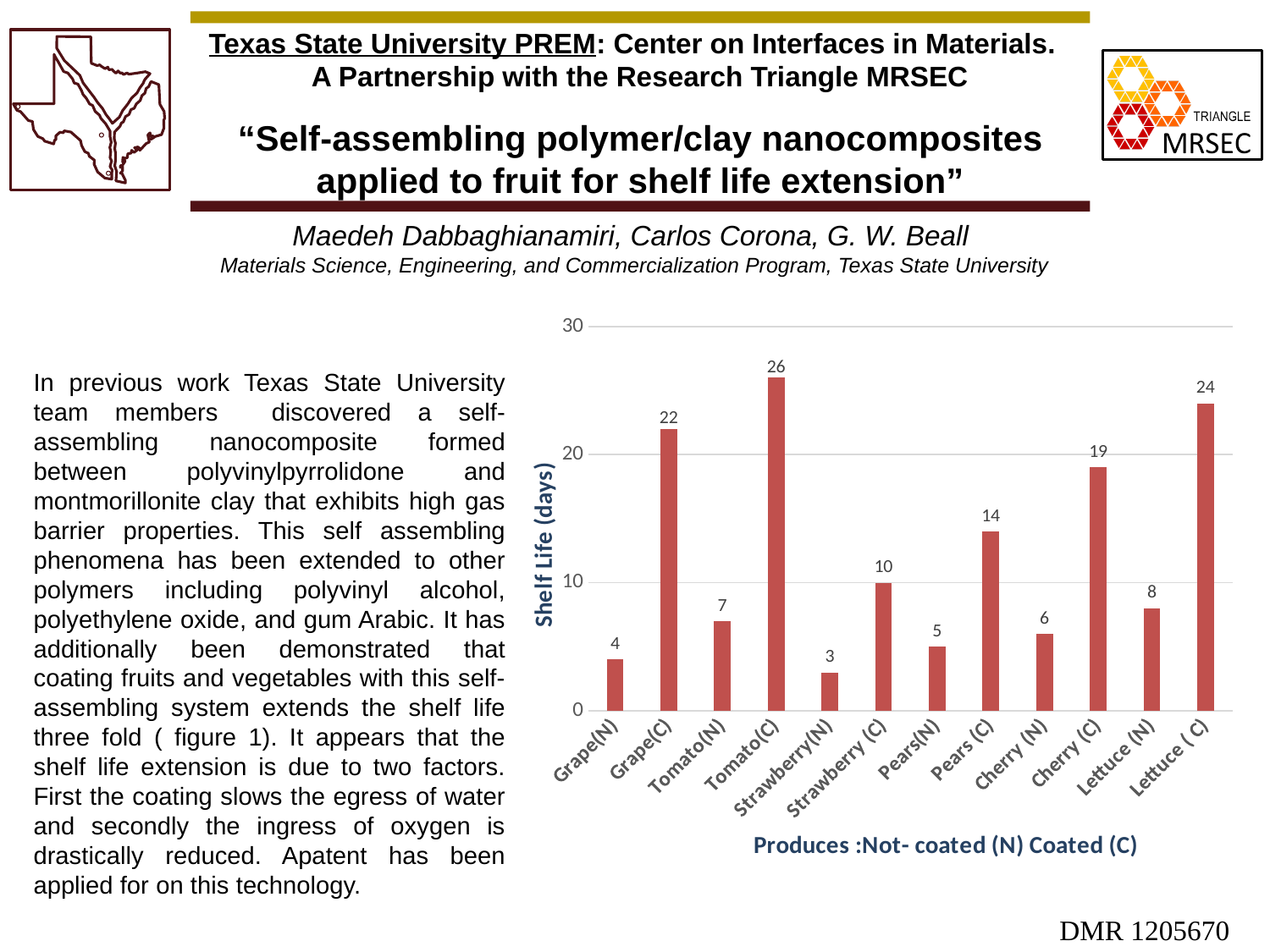
Which category has the lowest shelf life? Strawberry(N) Which category has the highest shelf life? Tomato(C) What kind of chart is shown on the slide? Bar chart What is the shelf life in days for Strawberry(N)? 3 Which has a longer shelf life, Pears (C) or Strawberry (C)? Pears (C) What is the difference in shelf life between Cherry (C) and Cherry (N)? 13 How many categories are shown on the x axis? 12 What is the difference in shelf life between Grape(C) and Grape(N)? 18 What is the shelf life in days for Tomato(C)? 26 What is the shelf life in days for Lettuce (C)? 24 What is the label of the x axis? Produces :Not- coated (N) Coated (C) What is the label of the y axis? Shelf Life (days)